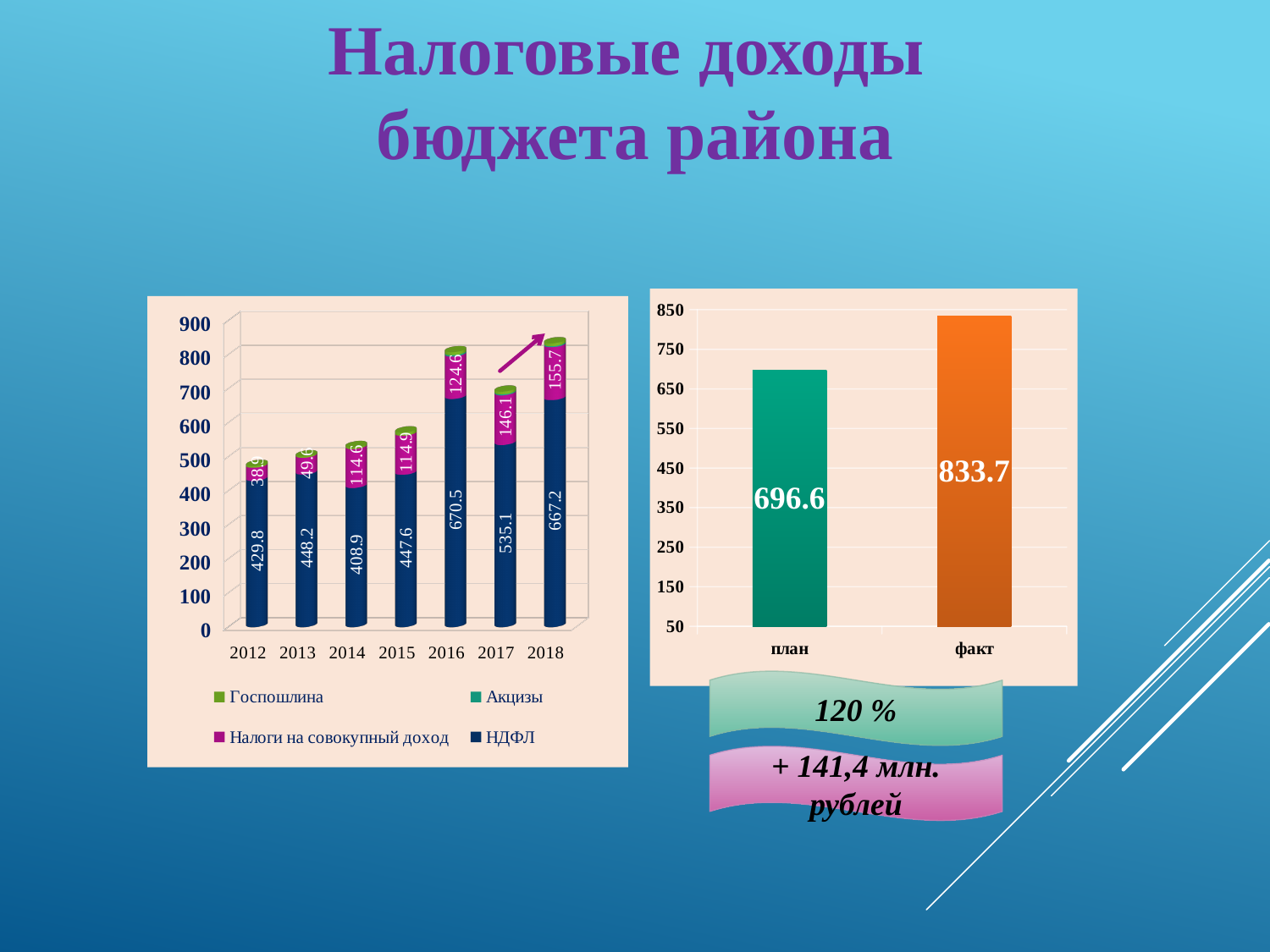
In the left chart, how many series does the legend list? 4 In the left chart, what is the value of Налоги на совокупный доход for 2017? 146.1 In the left chart, what is the difference between the НДФЛ values for 2016 and 2017? 135.4 In the left chart, what is the НДФЛ value for 2014? 408.9 In the left chart, which year has the lowest НДФЛ value? 2014 In the left chart, how many years are shown on the x axis? 7 In the right chart, what is the difference between факт and план? 137.1 What kind of chart is the right chart? bar chart In the left chart, what is the НДФЛ value for 2016? 670.5 In the right chart, what is the value for факт? 833.7 In the left chart, is the НДФЛ value for 2018 greater or less than the value for 2017? greater In the left chart, which year has the highest НДФЛ value? 2016